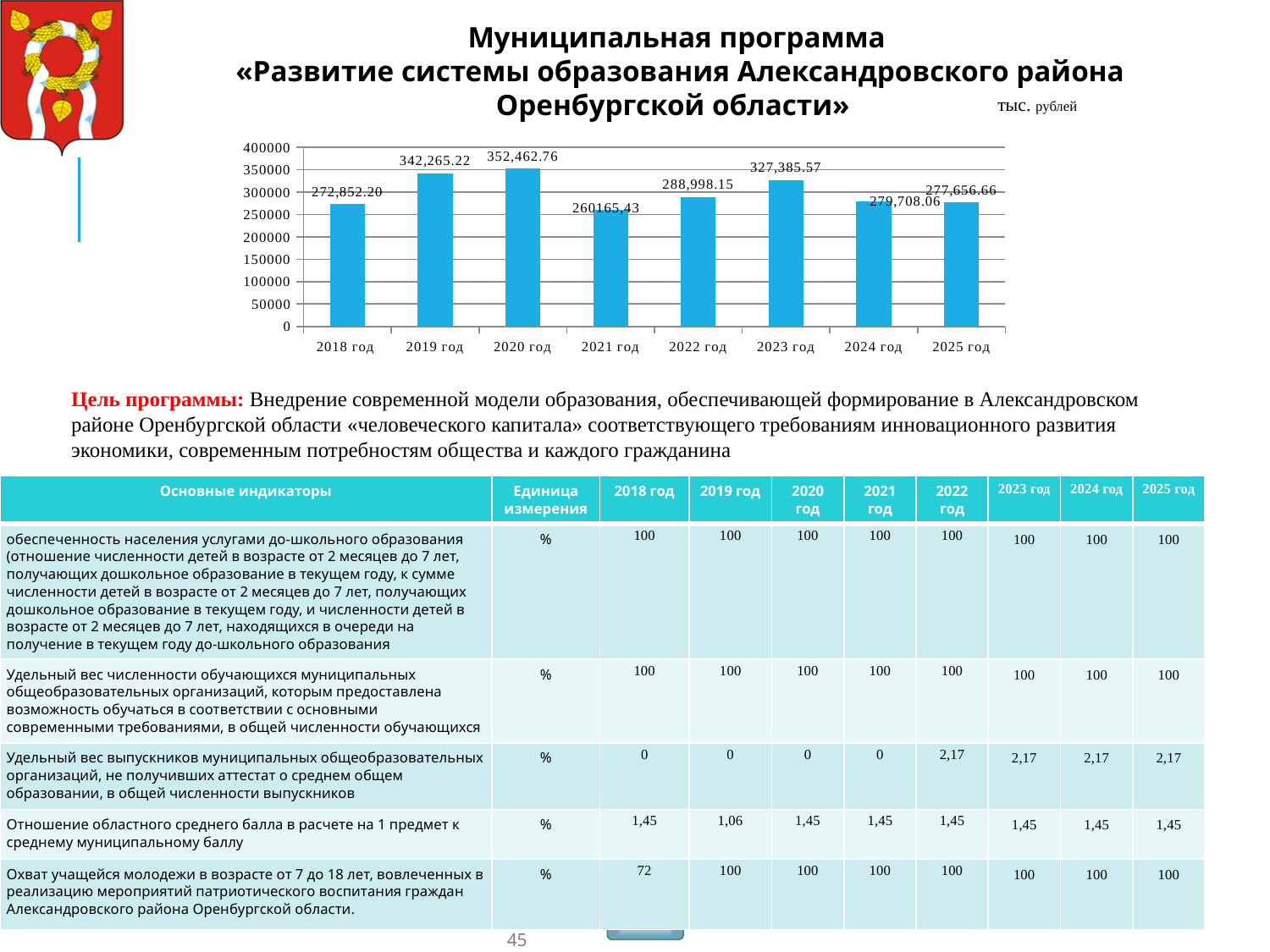
Which year has the lowest value on the chart? 2021 год What is the value for 2023 год on the chart? 327,385.57 How many years (bars) are shown on the chart? 8 Which year has the highest value on the chart? 2020 год What is the value for 2025 год on the chart? 277,656.66 Is the value for 2021 год greater or less than 300000? less Which is larger, the value for 2019 год or the value for 2022 год? 2019 год What is the value for 2018 год on the chart? 272,852.20 What type of chart is shown on the slide? bar chart What is the difference between the values for 2023 год and 2022 год? 38,387.42 What unit of measurement is indicated for the chart values? тыс. рублей What is the difference between the values for 2020 год and 2019 год? 10,197.54